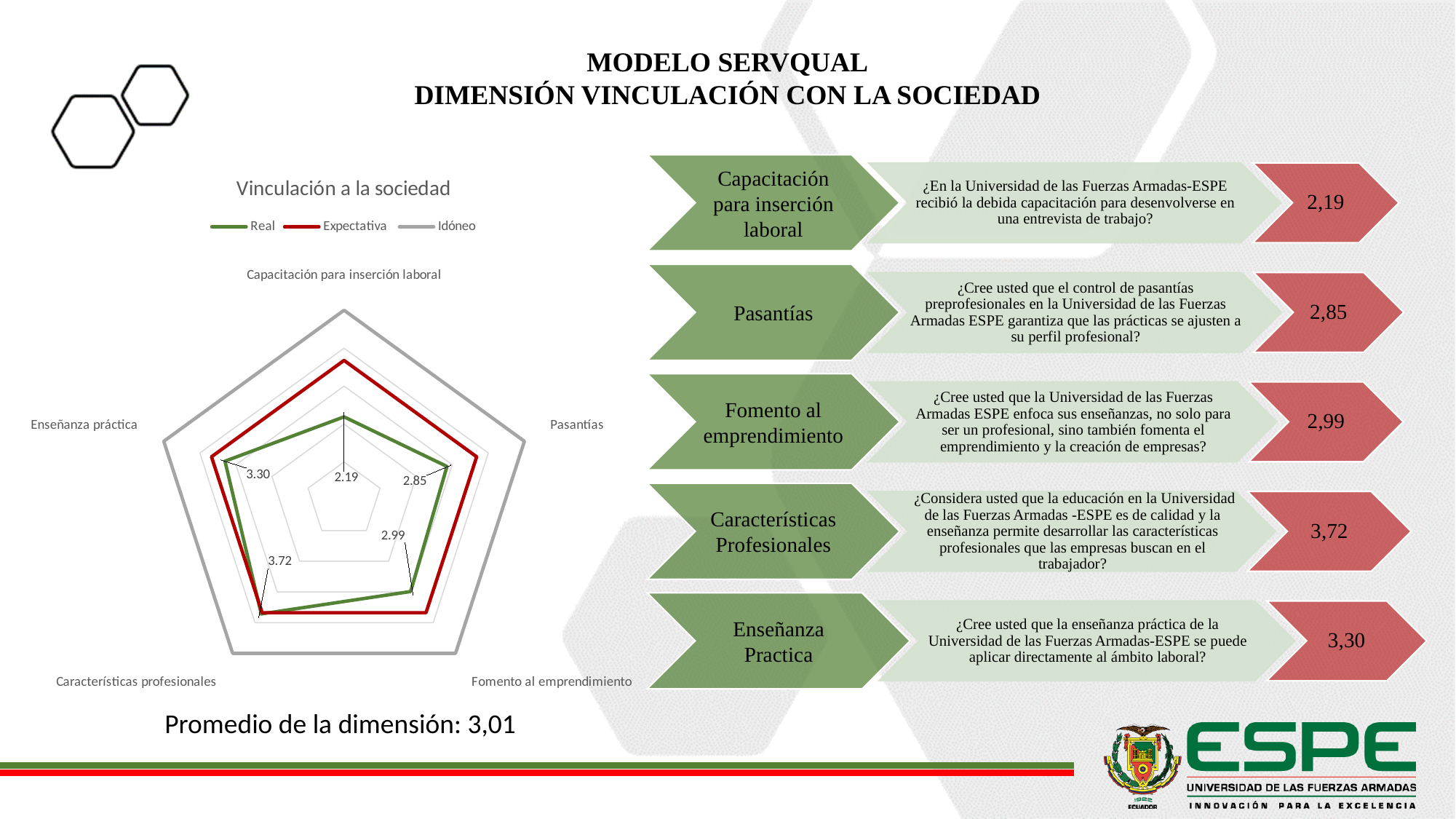
Which has a larger Real value, Pasantías or Enseñanza práctica? Enseñanza práctica What is the difference between the Real values for Características profesionales and Capacitación para inserción laboral? 1.53 What is the Real value for Capacitación para inserción laboral in the radar chart? 2.19 How many series does the legend of the radar chart list? 3 What is the Real value for Pasantías in the radar chart? 2.85 How many categories (axes) does the radar chart have? 5 What is the Real value for Fomento al emprendimiento in the radar chart? 2.99 What is the Real value for Características profesionales in the radar chart? 3.72 What is the Real value for Enseñanza práctica in the radar chart? 3.30 Which category has the lowest Real value in the radar chart? Capacitación para inserción laboral Which category has the highest Real value in the radar chart? Características profesionales What is the title of the chart on the slide? Vinculación a la sociedad